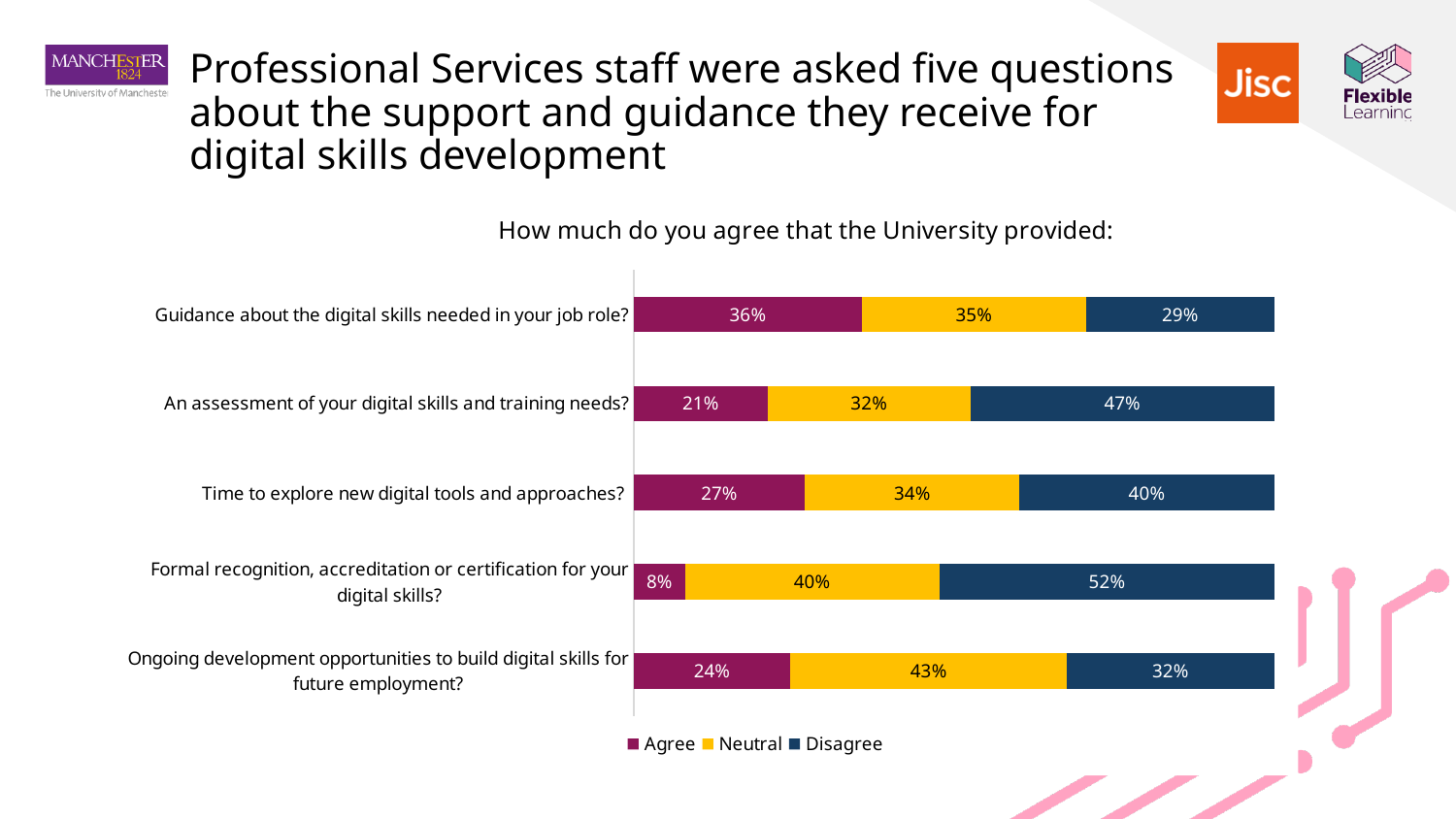
Which question has the highest Disagree percentage? Formal recognition, accreditation or certification for your digital skills? What is the difference between the Disagree and Agree percentages for 'An assessment of your digital skills and training needs?' 26 percentage points What percentage of Professional Services staff agreed that the University provided guidance about the digital skills needed in their job role? 36% How many questions (categories) are shown in the chart? 5 Which question has the highest Agree percentage? Guidance about the digital skills needed in your job role? How many series does the legend list? 3 Is the Agree percentage higher for 'Time to explore new digital tools and approaches?' or for 'Ongoing development opportunities to build digital skills for future employment?' Time to explore new digital tools and approaches? What is the Disagree value for 'Formal recognition, accreditation or certification for your digital skills?' 52% What type of chart is shown on the slide? Stacked bar chart What is the Neutral value for 'Ongoing development opportunities to build digital skills for future employment?' 43% Which question has the lowest Agree percentage? Formal recognition, accreditation or certification for your digital skills? What is the total of the stacked bar for 'Guidance about the digital skills needed in your job role?' 100%